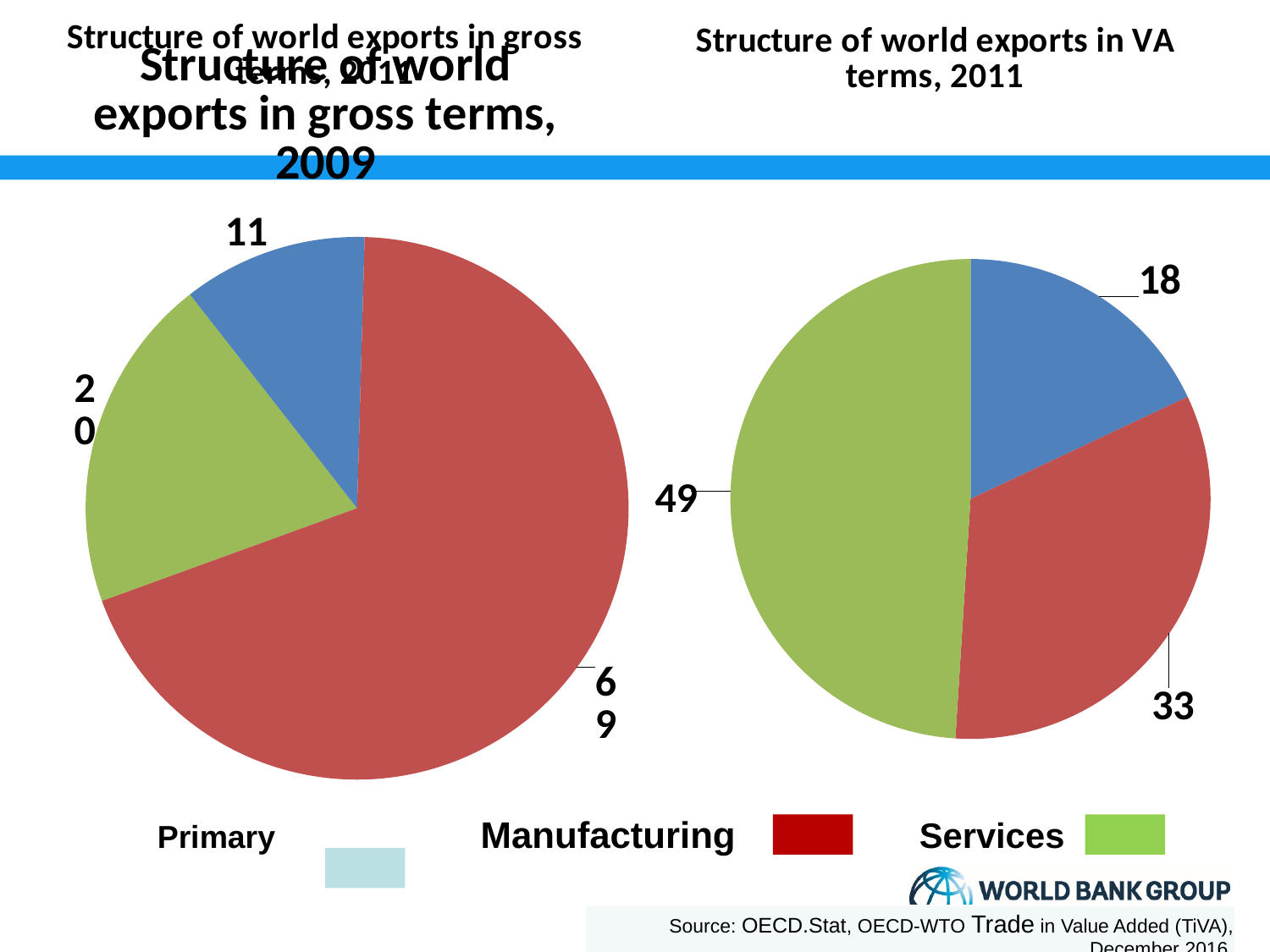
What kind of chart is used on this slide? Pie chart In the chart titled 'Structure of world exports in VA terms, 2011', which category has the smallest slice? Primary In the left pie chart (gross terms), what is the value shown for Primary? 11 How many categories does the legend list? 3 In the chart titled 'Structure of world exports in VA terms, 2011', what is the value shown for Manufacturing? 33 In the left pie chart (gross terms), what is the value shown for Services? 20 In the left pie chart (gross terms), what is the value shown for Manufacturing? 69 In the chart titled 'Structure of world exports in VA terms, 2011', what is the value shown for Services? 49 In the left pie chart (gross terms), which category has the largest slice? Manufacturing In the chart titled 'Structure of world exports in VA terms, 2011', what is the value shown for Primary? 18 Is the Services value larger in the left pie chart (gross terms) or in the right pie chart (VA terms)? Right pie chart (VA terms) How much larger is the Manufacturing value in the left pie chart (gross terms) than in the right pie chart (VA terms)? 36